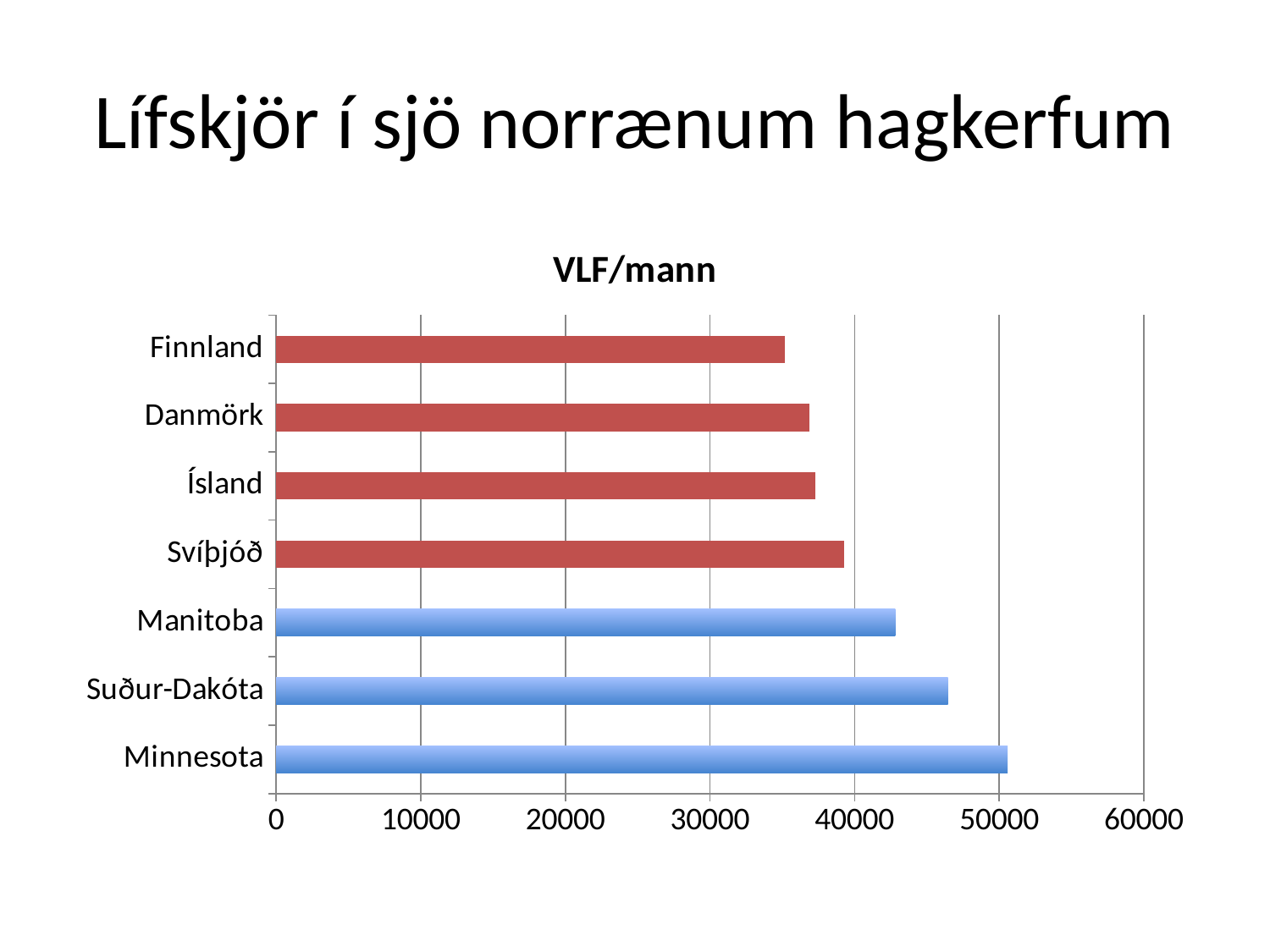
Is the value for Suður-Dakóta greater or less than 50000? less Is the value for Finnland greater or less than 30000? greater Is the value for Manitoba greater or less than 40000? greater How many categories are plotted in the chart? 7 Which category has the lowest value in the chart? Finnland Which has the larger value, Suður-Dakóta or Svíþjóð? Suður-Dakóta What is the title of the chart? VLF/mann Which category has the highest value in the chart? Minnesota What kind of chart is shown on the slide? bar chart How many bars in the chart are coloured blue? 3